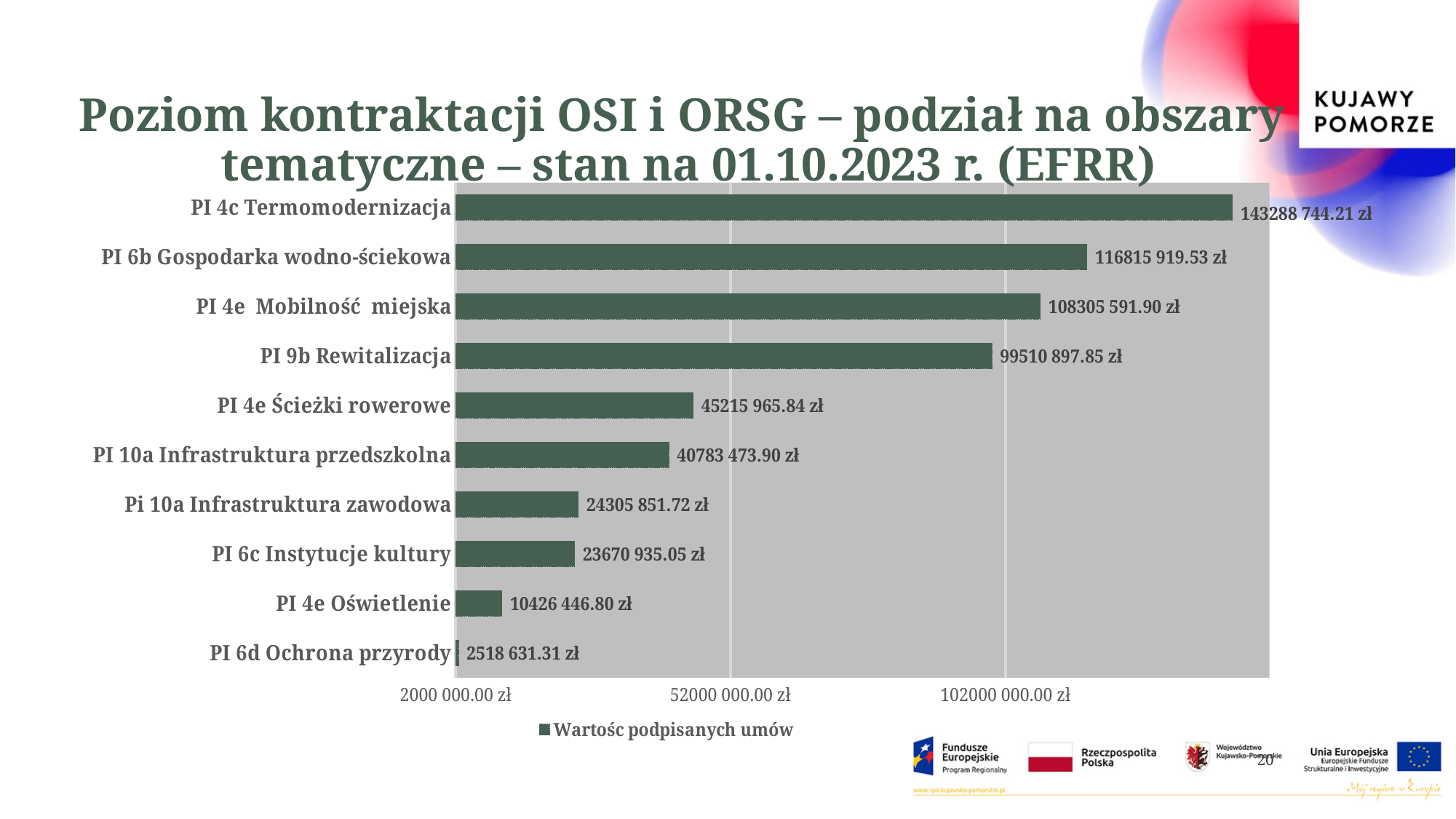
How many series does the legend list? 1 What is the value for PI 4c Termomodernizacja? 143288 744.21 zł Which category has the highest value? PI 4c Termomodernizacja What kind of chart is shown on the slide? bar chart What is the value for PI 4e Oświetlenie? 10426 446.80 zł What is the value for PI 9b Rewitalizacja? 99510 897.85 zł What is the difference between the values for PI 4c Termomodernizacja and PI 6b Gospodarka wodno-ściekowa? 26472 824.68 zł Which category has the lowest value? PI 6d Ochrona przyrody How many categories are shown in the chart? 10 Is the value for PI 4e Ścieżki rowerowe greater or less than 52000 000.00 zł? less Which is larger: the value for PI 4e Mobilność miejska or PI 9b Rewitalizacja? PI 4e Mobilność miejska Is the value for PI 4e Mobilność miejska greater or less than 102000 000.00 zł? greater